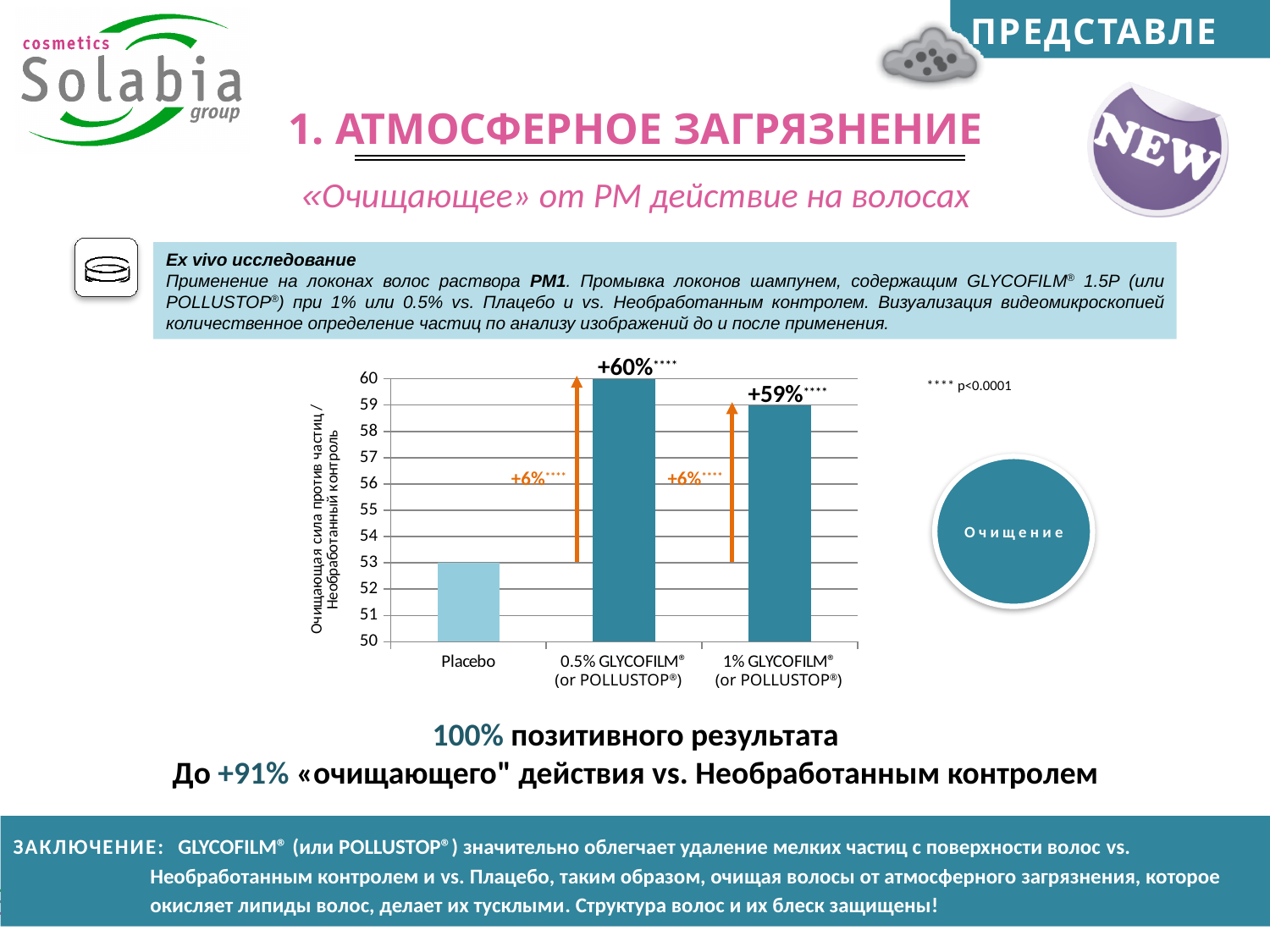
How many categories are shown on the x axis of the chart? 3 What data label is shown on the bar for 0.5% GLYCOFILM (or POLLUSTOP)? +60% What increase is annotated by the orange arrows between Placebo and each GLYCOFILM bar? +6% Which bar is taller: 0.5% GLYCOFILM or 1% GLYCOFILM? 0.5% GLYCOFILM Which category has the highest bar in the chart? 0.5% GLYCOFILM (or POLLUSTOP) What is the difference between the labelled values for 0.5% GLYCOFILM and 1% GLYCOFILM? 1% What kind of chart is shown on the slide? bar chart Which category has the lowest bar in the chart? Placebo Is the value for 1% GLYCOFILM greater or less than 57? greater Is the value for Placebo greater or less than 55? less What significance level do the four asterisks (****) on the chart indicate? p<0.0001 What data label is shown on the bar for 1% GLYCOFILM (or POLLUSTOP)? +59%